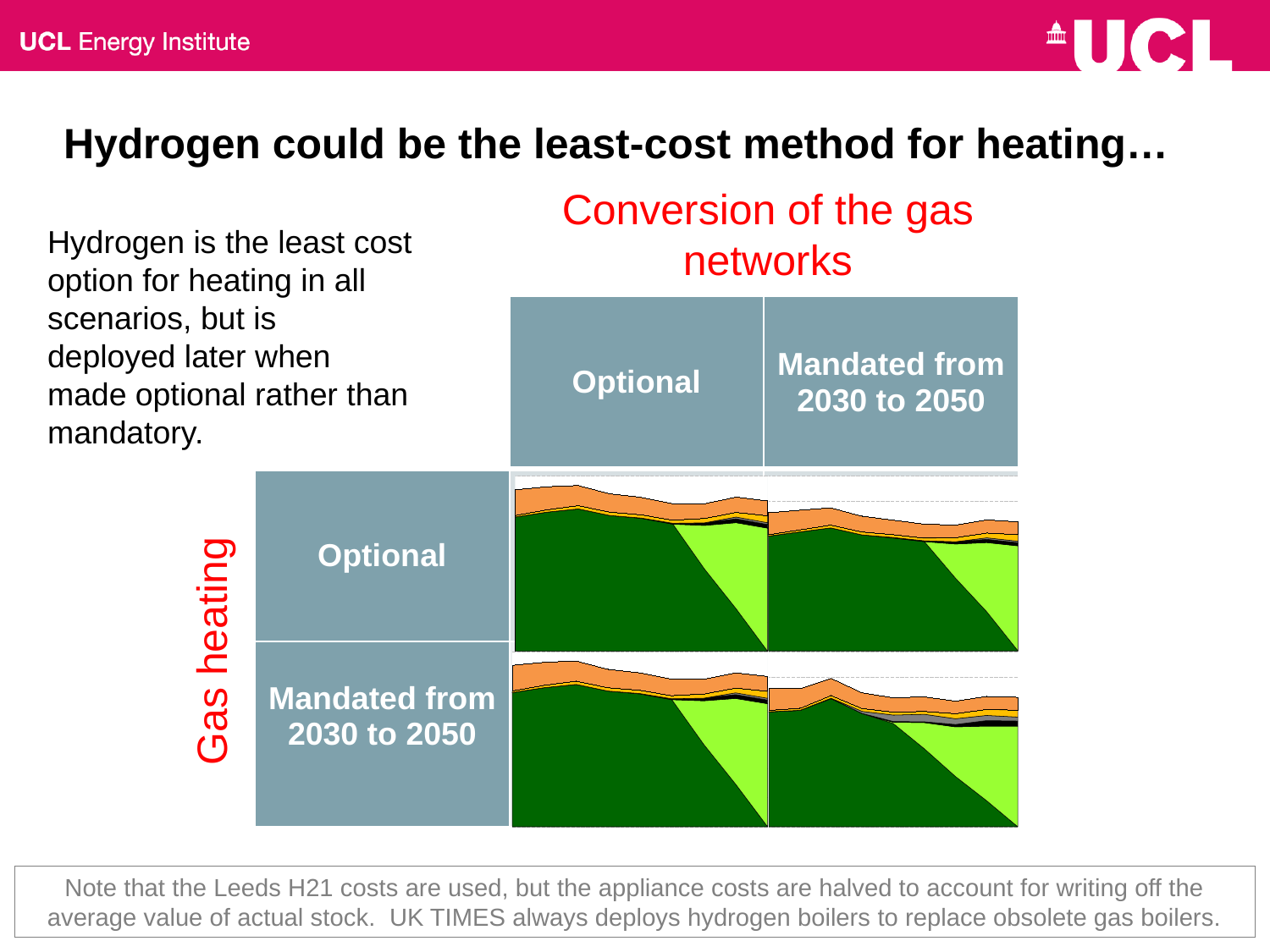
What kind of chart is used in each of the four panels of the grid? area chart In the top-left chart (Optional gas heating, Optional conversion), does the dark green area rise or fall moving from left to right? fall In the bottom-right chart (Mandated gas heating, Mandated conversion), does the light green area rise or fall moving from left to right? rise What is the red heading printed above the column headers of the chart grid? Conversion of the gas networks What is the red label written vertically beside the row headers of the chart grid? Gas heating How many small charts are arranged in the grid on the slide? 4